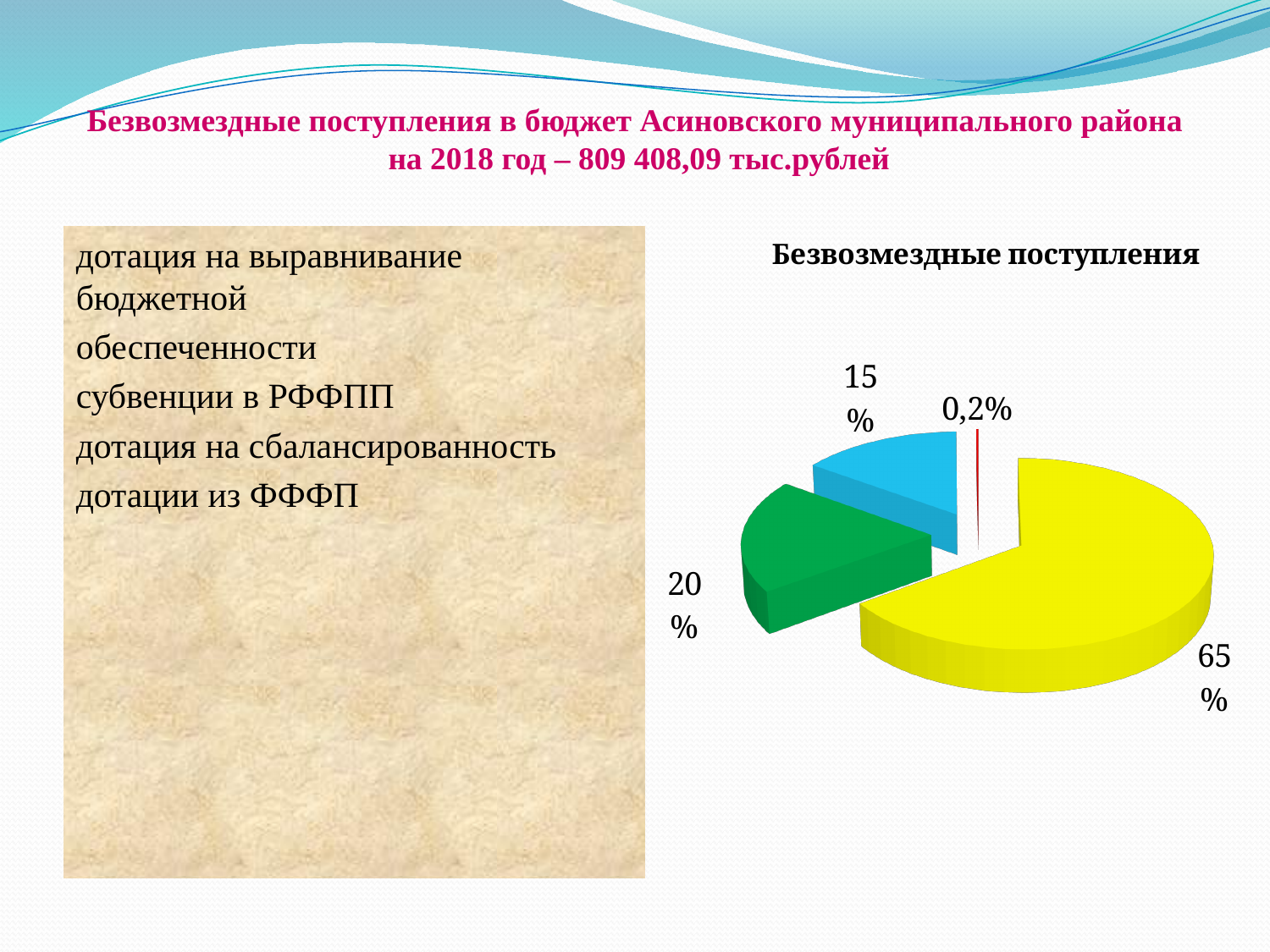
What percentage is shown for the blue slice of the pie chart? 15% What is the title of the pie chart? Безвозмездные поступления What percentage is shown for the green slice of the pie chart? 20% What is the value of the smallest slice in the pie chart? 0,2% How many slices does the pie chart have? 4 What is the value of the largest slice in the pie chart? 65% What is the difference between the yellow slice (65%) and the green slice (20%)? 45 percentage points What is the difference between the green slice (20%) and the blue slice (15%)? 5 percentage points What colour is the largest slice of the pie chart? Yellow Which slice is larger, the green one or the blue one? The green one (20%) What percentage is shown for the yellow slice of the pie chart? 65% What kind of chart is shown on the slide? Pie chart